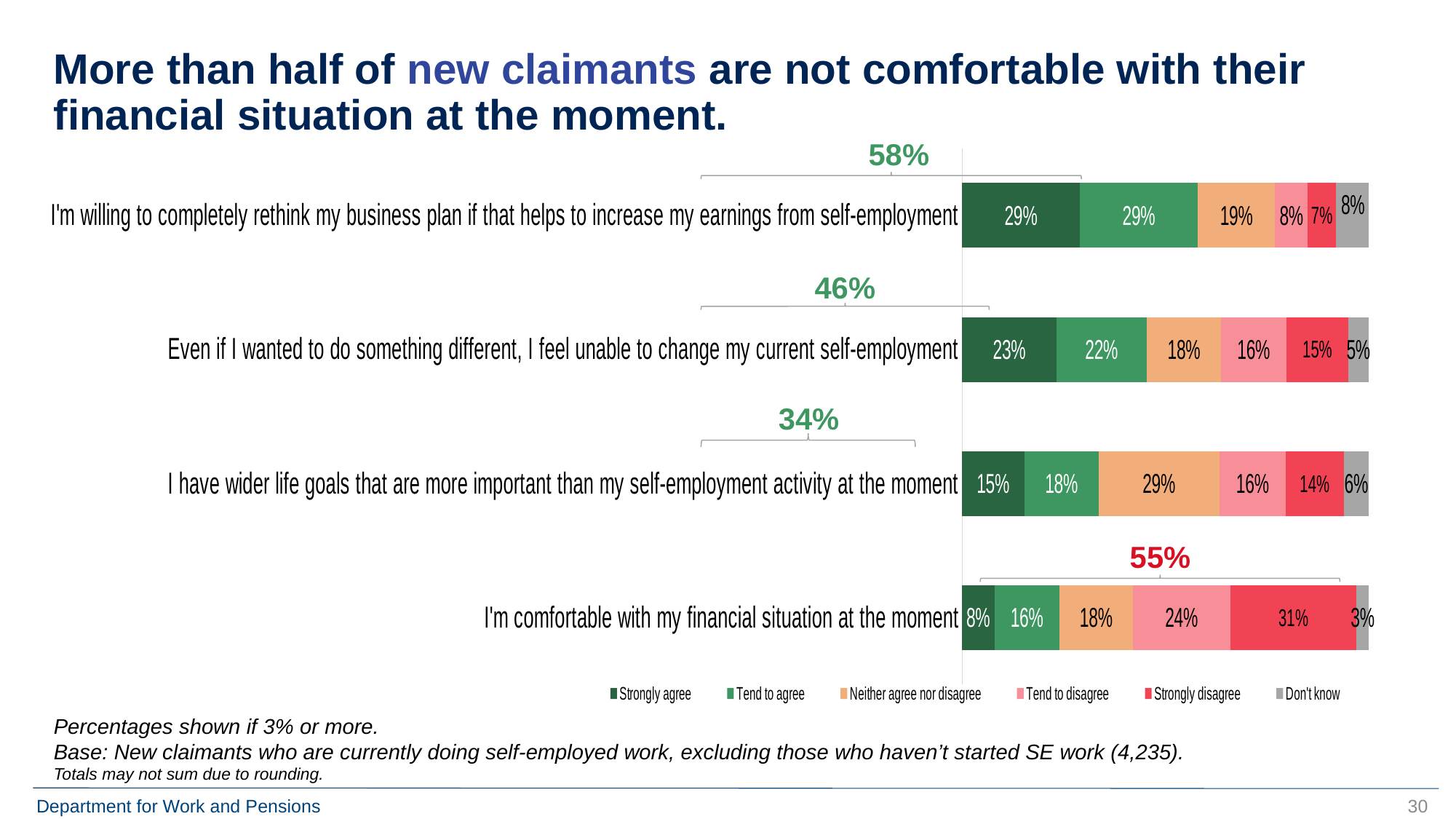
What percentage strongly disagree with "I'm comfortable with my financial situation at the moment"? 31% Which statement has the lowest 'Don't know' percentage? I'm comfortable with my financial situation at the moment What type of chart is shown on the slide? Stacked bar chart What combined percentage is shown above the bar for "I'm willing to completely rethink my business plan if that helps to increase my earnings from self-employment"? 58% What is the difference between the 'Strongly disagree' and 'Tend to disagree' percentages for "I'm comfortable with my financial situation at the moment"? 7% What percentage neither agree nor disagree with "I have wider life goals that are more important than my self-employment activity at the moment"? 29% How many statements are shown in the chart? 4 What percentage tend to agree with "Even if I wanted to do something different, I feel unable to change my current self-employment"? 22% Which statement has the highest 'Strongly agree' percentage? I'm willing to completely rethink my business plan if that helps to increase my earnings from self-employment For "I have wider life goals that are more important than my self-employment activity at the moment", which is larger: 'Tend to agree' or 'Strongly agree'? Tend to agree How many response categories does the legend list? 6 What percentage strongly agree with "I'm comfortable with my financial situation at the moment"? 8%